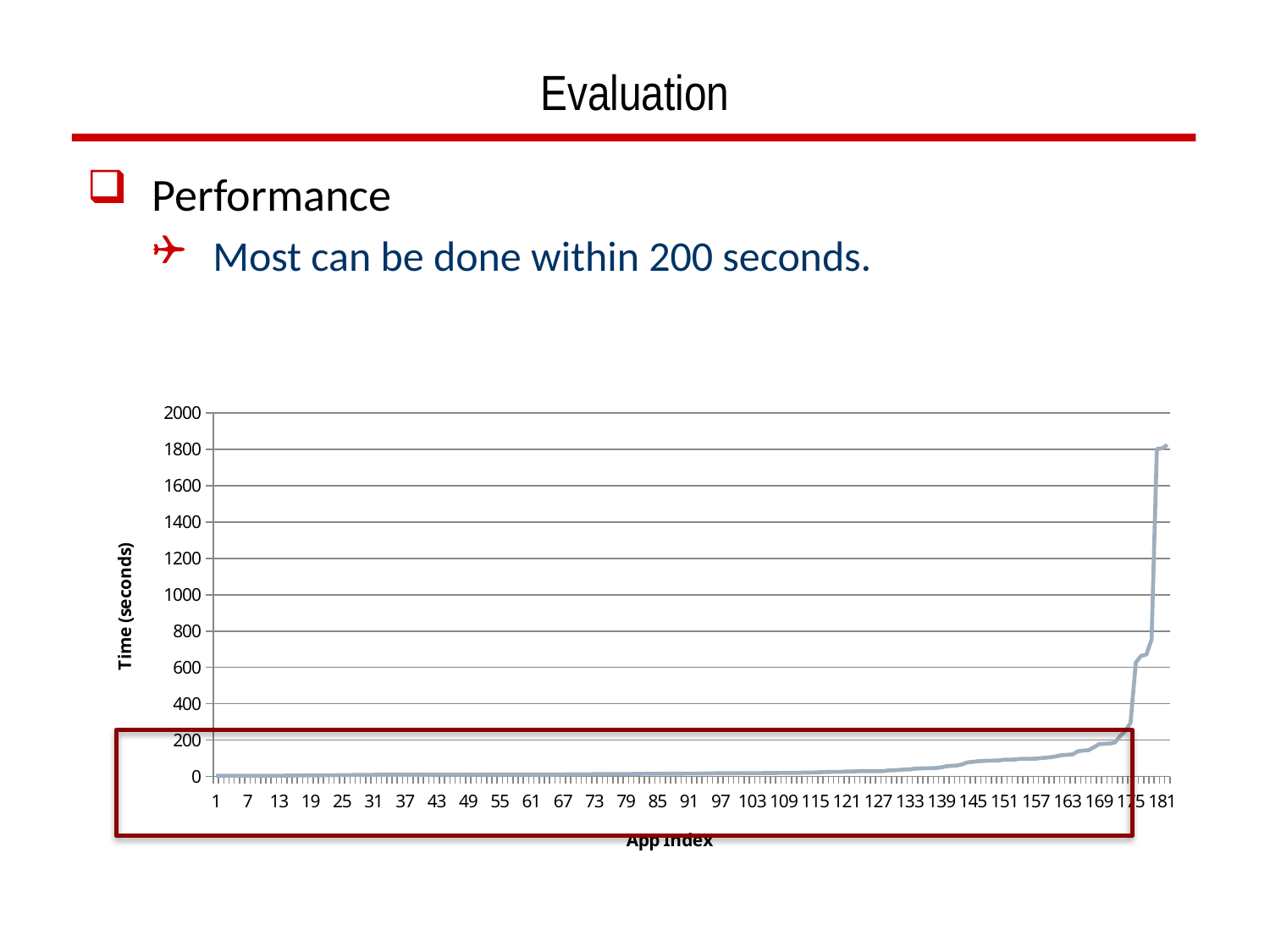
What is the title of the vertical axis? Time (seconds) Do the values rise or fall as the app index increases along the x axis? rise Is the value for app index 181 greater or less than 2000? less Is the value for app index 139 greater or less than 600? less Is the value for app index 91 greater or less than 200? less Which has the larger value, app index 1 or app index 181? app index 181 What kind of chart is shown on the slide? line chart What is the title of the horizontal axis? App Index Which has the larger value, app index 103 or app index 175? app index 175